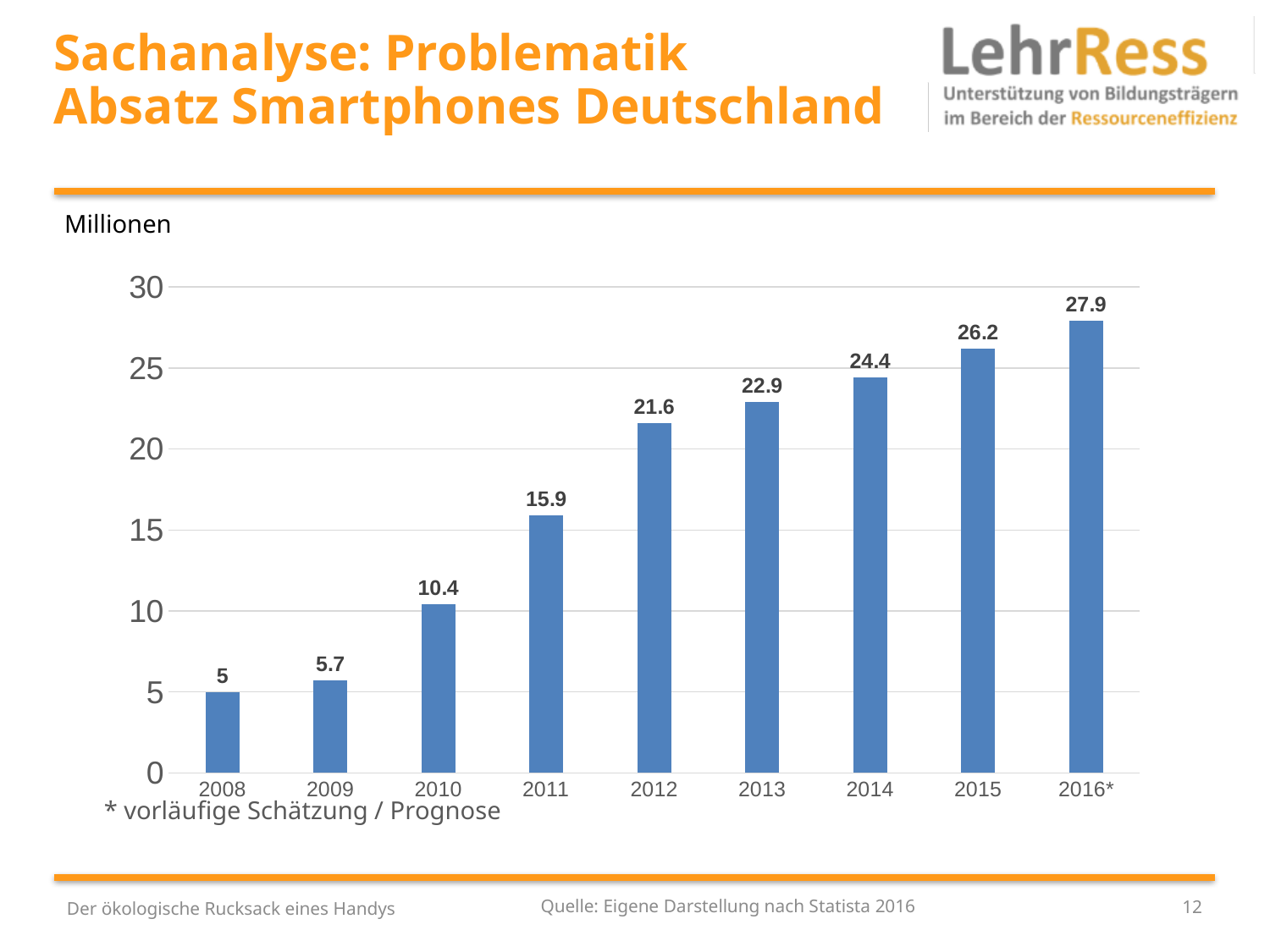
What is the value for 2016*? 27.9 Which is larger, the value for 2013 or the value for 2011? 2013 What kind of chart is shown? bar chart How many years are shown on the x axis? 9 What is the value for 2012? 21.6 Which year has the lowest value? 2008 What is the difference between the values for 2015 and 2014? 1.8 Is the value for 2014 greater or less than 20? greater What is the value for 2008? 5 Which year has the highest value? 2016* Do the values rise or fall from 2008 to 2016*? rise What is the difference between the values for 2011 and 2010? 5.5